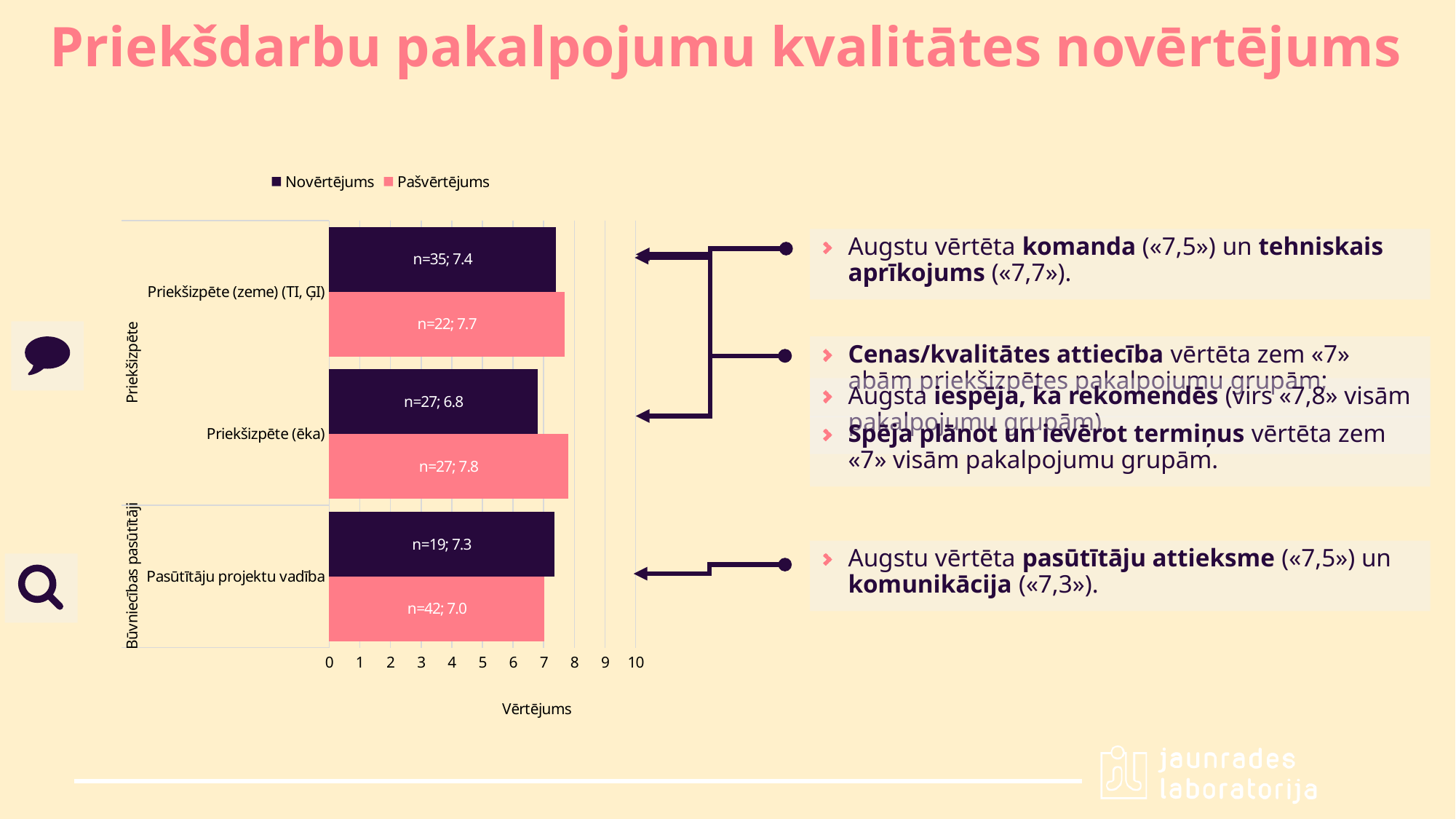
Which category has the lowest Novērtējums value? Priekšizpēte (ēka) What is the difference between the Pašvērtējums and Novērtējums values for Priekšizpēte (ēka)? 1.0 What is the Pašvērtējums value for Priekšizpēte (ēka)? 7.8 What type of chart is shown on the slide? Bar chart Is the Novērtējums value for Priekšizpēte (ēka) greater or less than 7? less What is the Novērtējums value for Priekšizpēte (zeme) (TI, ĢI)? 7.4 How many series does the legend list? 2 What is the sample size (n) shown on the Pašvērtējums bar for Pasūtītāju projektu vadība? n=42 How many categories are shown on the chart? 3 For Pasūtītāju projektu vadība, which is larger: the Novērtējums value or the Pašvērtējums value? Novērtējums Which category has the highest Pašvērtējums value? Priekšizpēte (ēka) What is the Pašvērtējums value for Pasūtītāju projektu vadība? 7.0